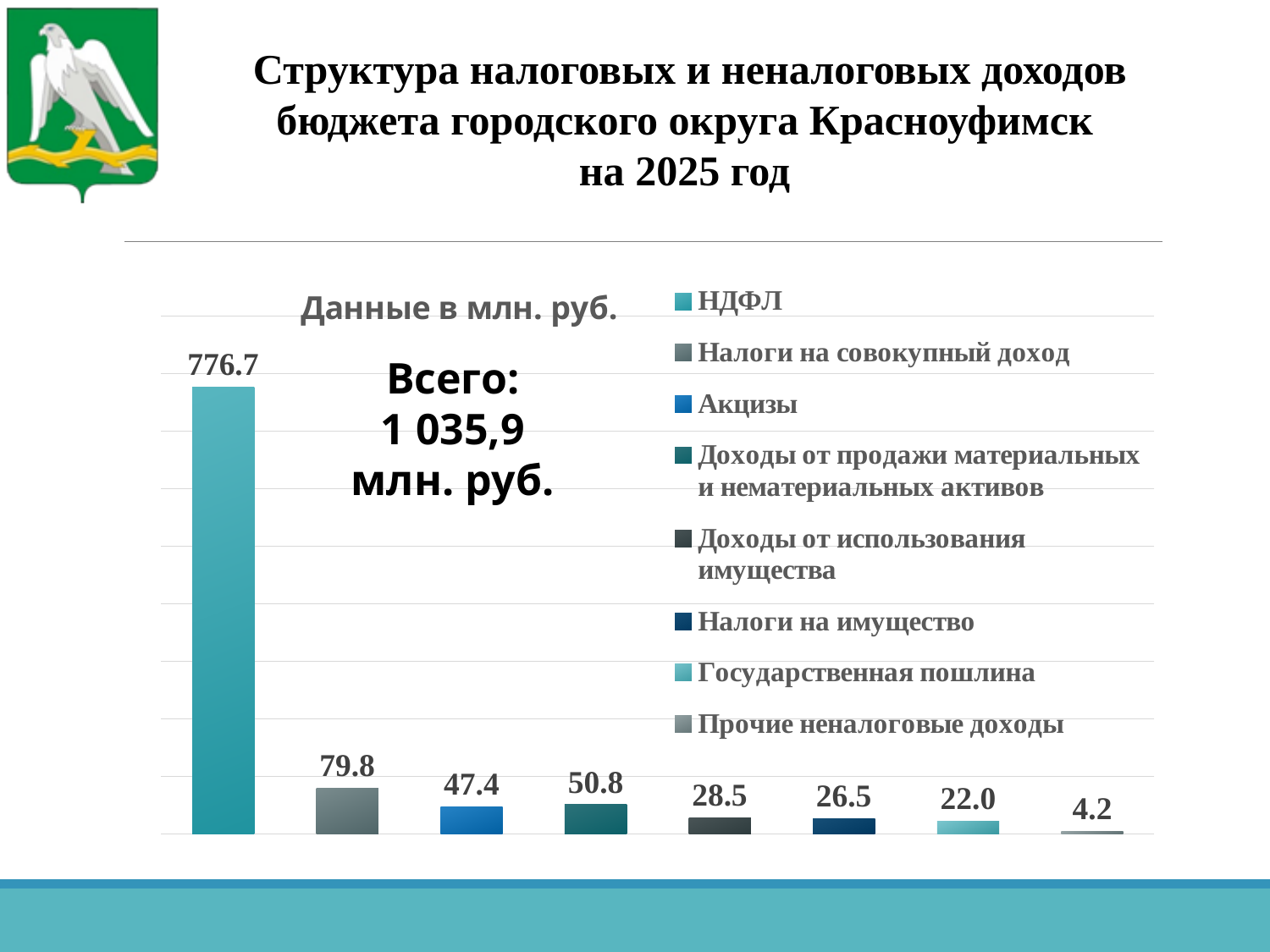
Which is larger: Доходы от использования имущества or Налоги на имущество? Доходы от использования имущества Which category has the lowest value? Прочие неналоговые доходы What is the value for Акцизы? 47.4 What is the value for Государственная пошлина? 22.0 How many bars are plotted in the chart? 8 How many entries does the legend list? 8 What total amount is stated in the text inside the chart area? 1 035,9 млн. руб. What is the value for Налоги на совокупный доход? 79.8 What type of chart is shown on the slide? bar chart What is the value for НДФЛ? 776.7 What is the difference between the values for Налоги на совокупный доход and Акцизы? 32.4 Which category has the highest value? НДФЛ